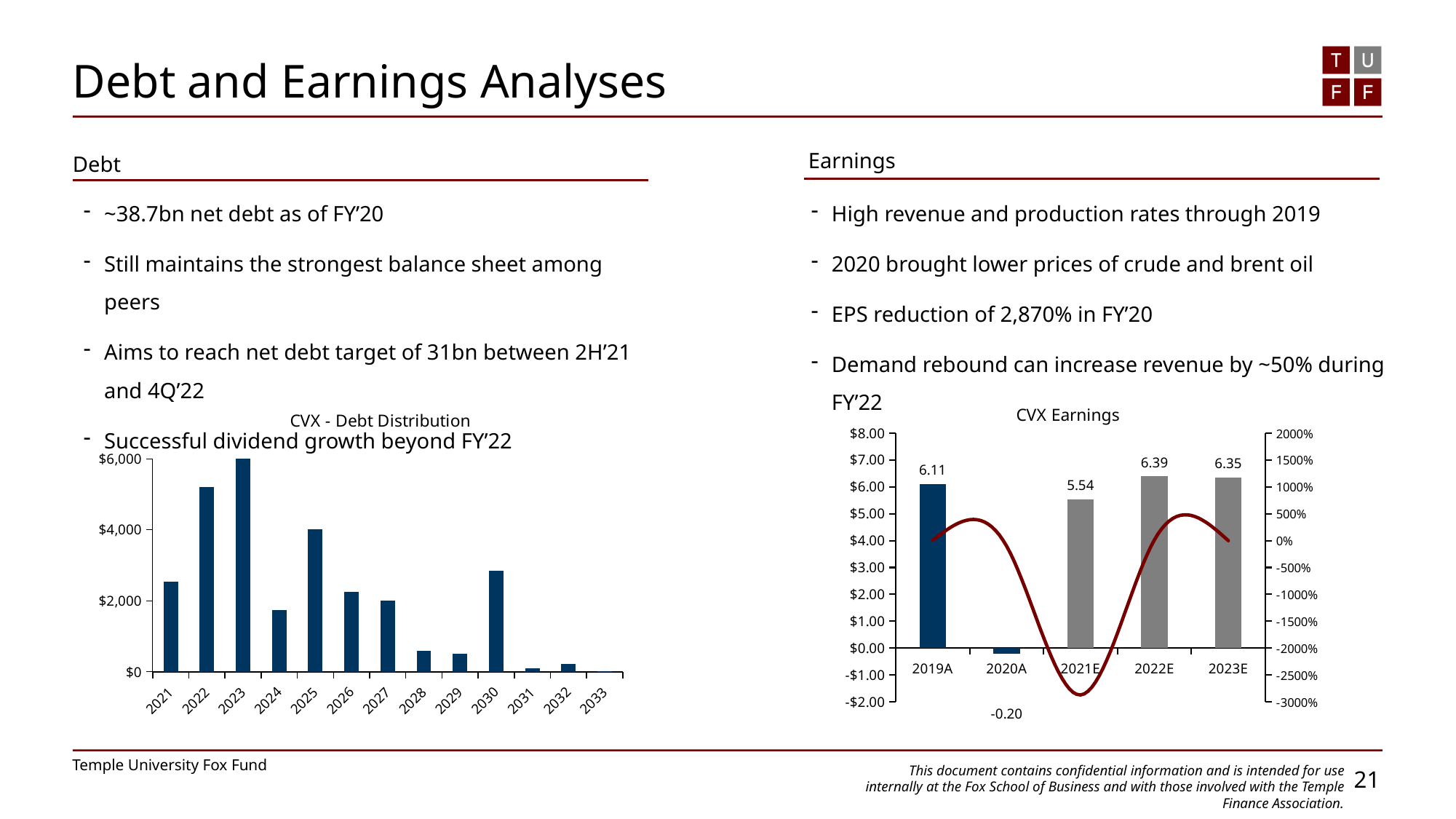
What kind of chart is the CVX - Debt Distribution chart? bar chart In the CVX - Debt Distribution chart, is the value for 2022 greater or less than $4,000? greater In the CVX Earnings chart, which year has the highest bar value? 2022E In the CVX Earnings chart, which is larger, the value for 2019A or for 2021E? 2019A In the CVX Earnings chart, what is the difference between the 2022E and 2021E values? 0.85 How many years are shown on the x axis of the CVX - Debt Distribution chart? 13 In the CVX Earnings chart, what is the value for 2019A? 6.11 How many years are shown on the x axis of the CVX Earnings chart? 5 In the CVX - Debt Distribution chart, is the value for 2028 greater or less than $2,000? less In the CVX Earnings chart, what is the value for 2020A? -0.20 In the CVX Earnings chart, what is the value for 2022E? 6.39 In the CVX Earnings chart, which year has the lowest bar value? 2020A